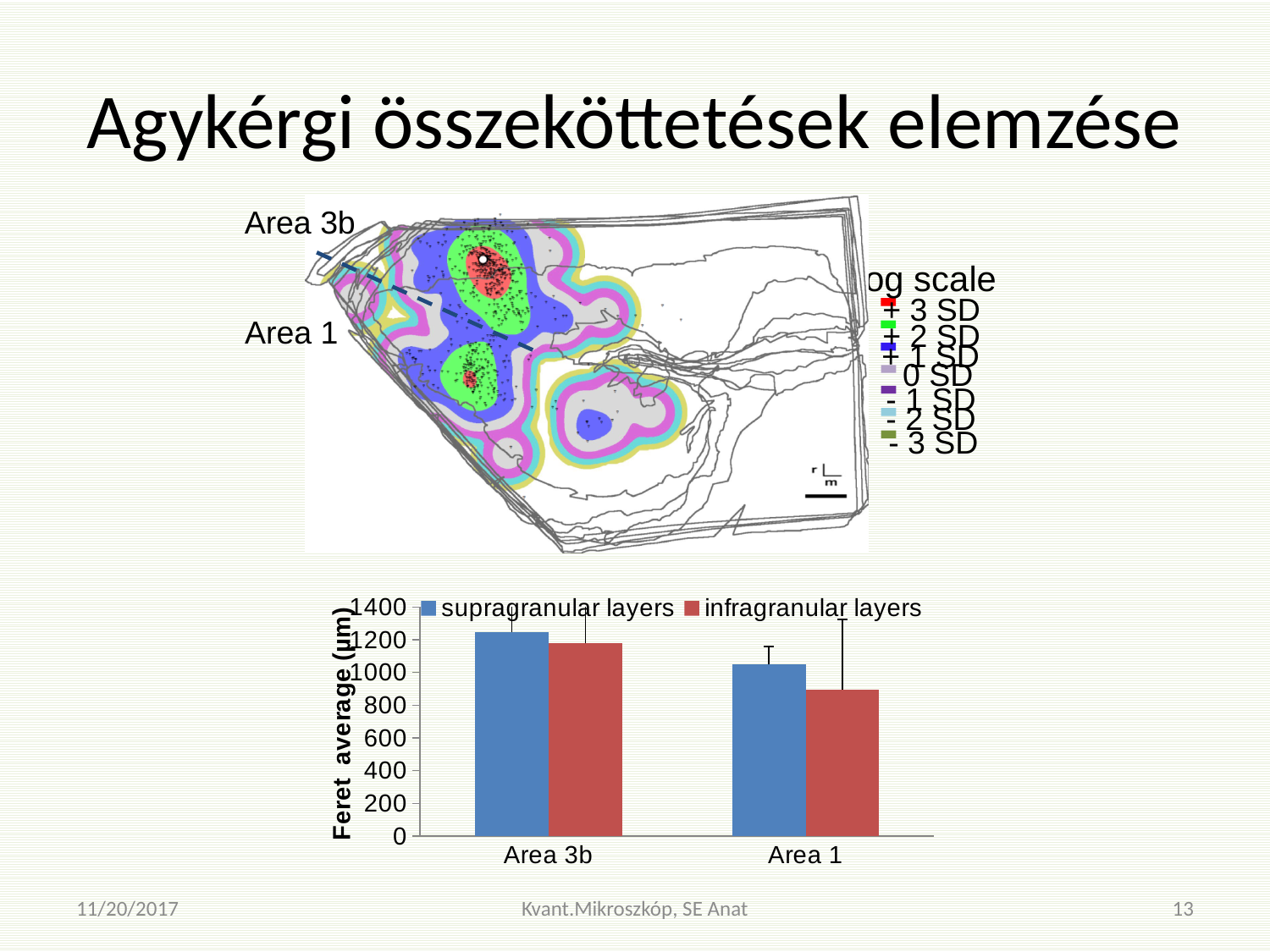
In the bar chart, which category has the lowest infragranular layers value? Area 1 In the bar chart, is the infragranular layers value for Area 1 greater or less than 1000? less How many series does the legend of the bar chart list? 2 In the bar chart, which category has the higher supragranular layers value, Area 3b or Area 1? Area 3b In the bar chart, for Area 1, which series has the larger value, supragranular layers or infragranular layers? supragranular layers What kind of chart is shown at the bottom of the slide? bar chart What is the label of the y axis of the bar chart? Feret average (µm) In the bar chart, is the supragranular layers value for Area 3b greater or less than 1000? greater In the bar chart, is the infragranular layers value for Area 3b greater or less than 1000? greater How many categories are shown on the x axis of the bar chart? 2 In the bar chart, do the values rise or fall from Area 3b to Area 1? fall